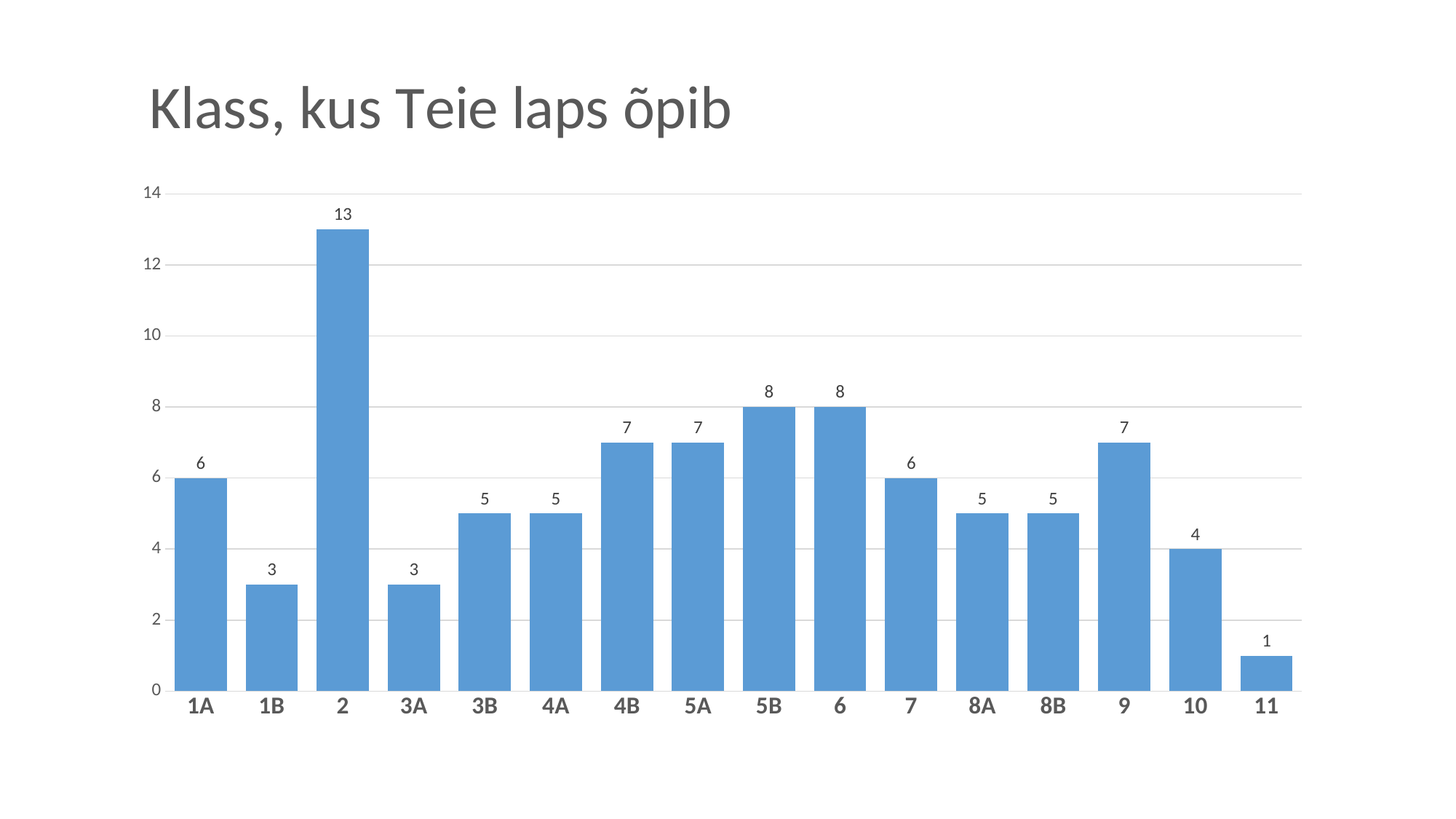
How many classes are shown on the x axis? 16 What is the value for class 10? 4 What is the title of the chart? Klass, kus Teie laps õpib What is the value for class 4B? 7 Which has a larger value, class 7 or class 6? 6 Which has a larger value, class 1B or class 9? 9 What is the difference between the values for class 2 and class 1A? 7 Which class has the highest value? 2 Which class has the lowest value? 11 What is the difference between the values for class 5B and class 8A? 3 What is the value for class 2? 13 What kind of chart is shown on the slide? bar chart